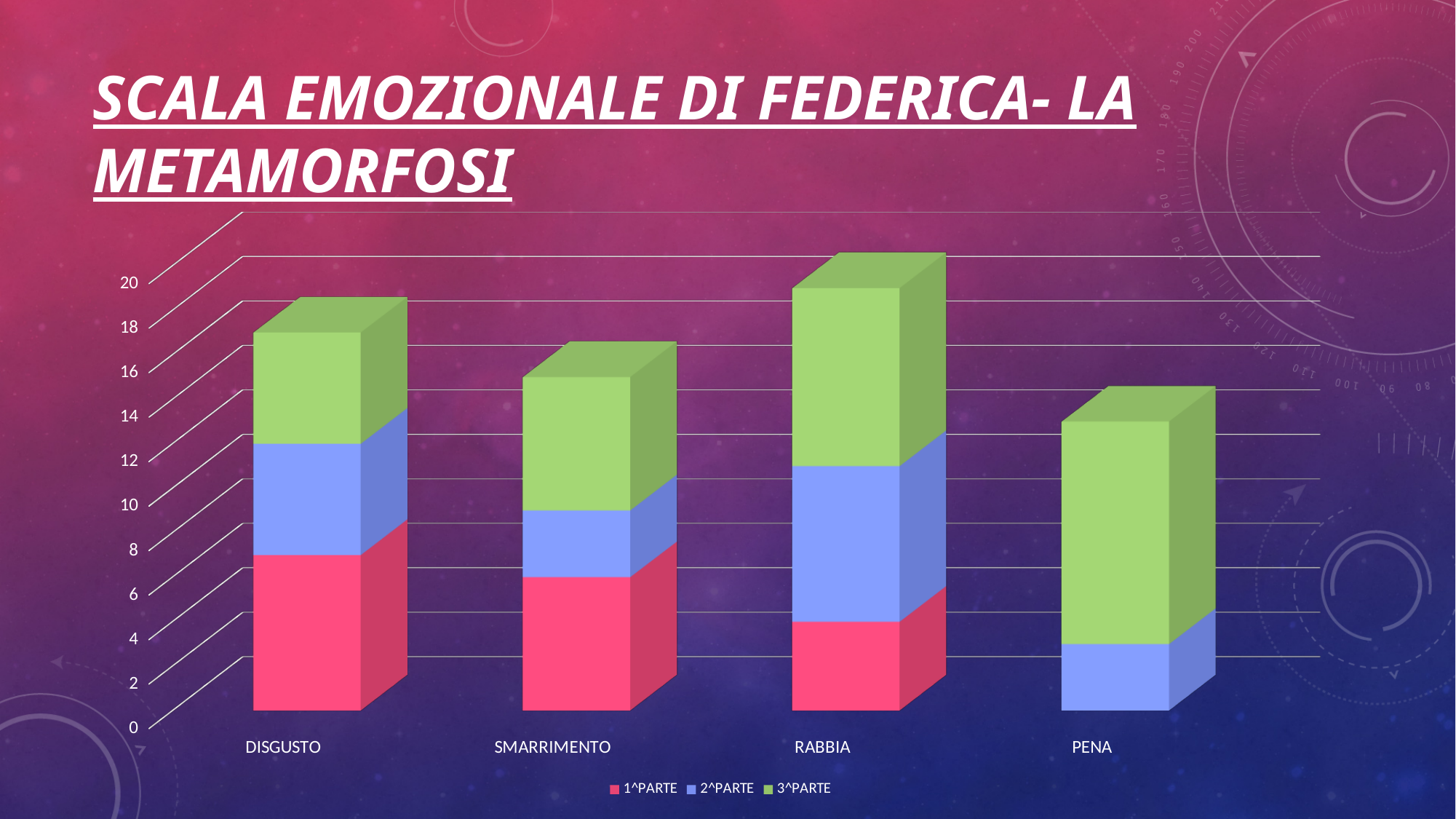
What is the title of the slide containing the chart? SCALA EMOZIONALE DI FEDERICA- LA METAMORFOSI Which category has the lowest total bar? PENA Which has the larger total bar, DISGUSTO or SMARRIMENTO? DISGUSTO Is the total for DISGUSTO greater or less than 14? greater Which has the larger 1^PARTE segment, DISGUSTO or RABBIA? DISGUSTO How many series does the chart legend list? 3 How many categories are shown on the x axis of the chart? 4 Is the total for PENA greater or less than 16? less Is the total for SMARRIMENTO greater or less than 12? greater Which category has the highest total bar? RABBIA What kind of chart is shown on the slide? Stacked bar chart